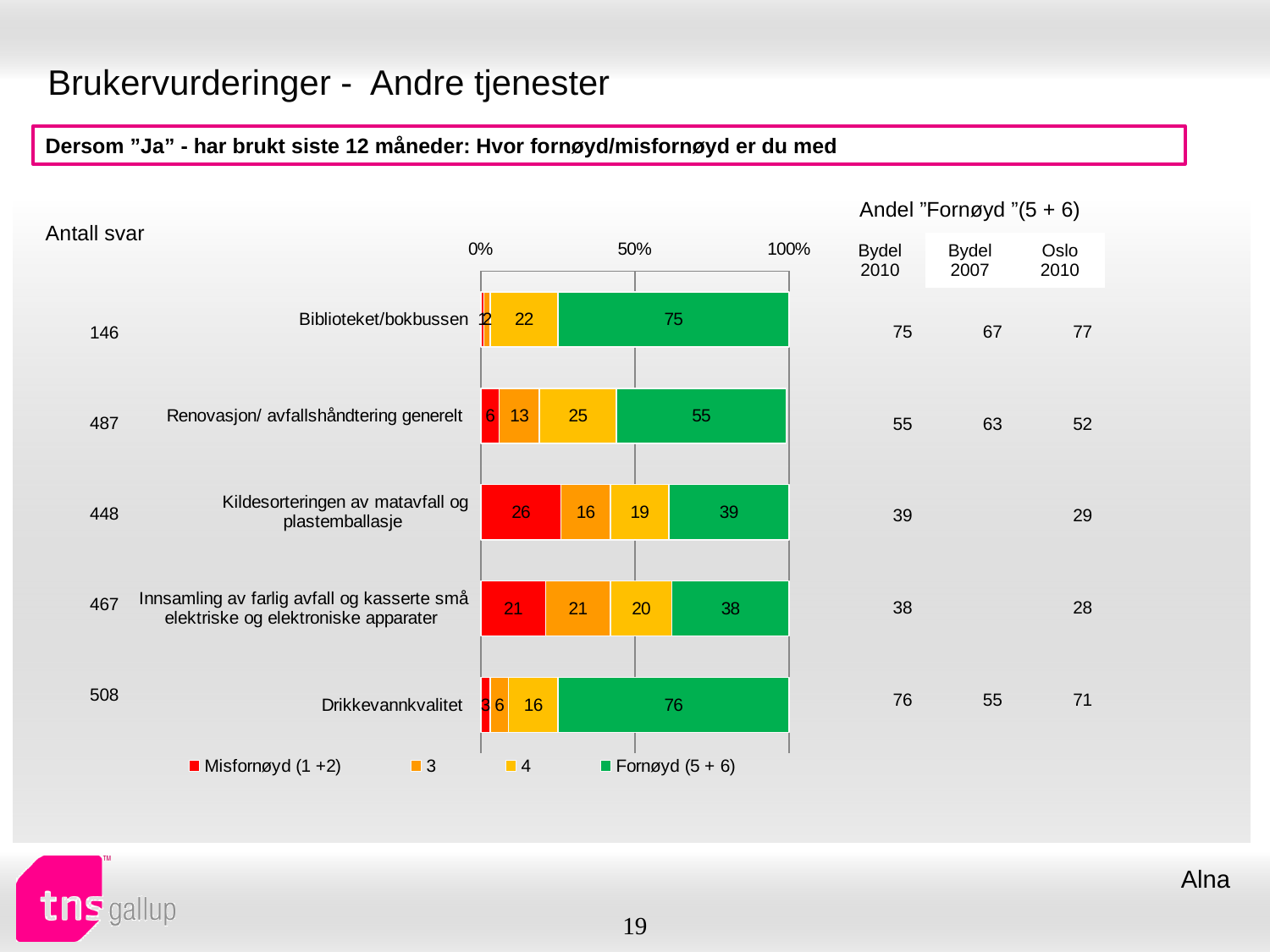
Which legend entry is shown in green? Fornøyd (5 + 6) Which category has the highest 'Fornøyd (5 + 6)' value? Drikkevannkvalitet What is the 'Fornøyd (5 + 6)' value for Biblioteket/bokbussen? 75 What is the difference between the 'Fornøyd (5 + 6)' values for Drikkevannkvalitet and Renovasjon/ avfallshåndtering generelt? 21 What is the value of series '4' for Renovasjon/ avfallshåndtering generelt? 25 How many series does the chart legend list? 4 What kind of chart is shown on the slide? stacked bar chart Which is larger: the 'Misfornøyd (1 +2)' value for Kildesorteringen av matavfall og plastemballasje or for Renovasjon/ avfallshåndtering generelt? Kildesorteringen av matavfall og plastemballasje How many categories (services) are plotted in the chart? 5 What is the value of series '3' for Innsamling av farlig avfall og kasserte små elektriske og elektroniske apparater? 21 Which category has the lowest 'Fornøyd (5 + 6)' value? Innsamling av farlig avfall og kasserte små elektriske og elektroniske apparater What is the 'Misfornøyd (1 +2)' value for Kildesorteringen av matavfall og plastemballasje? 26